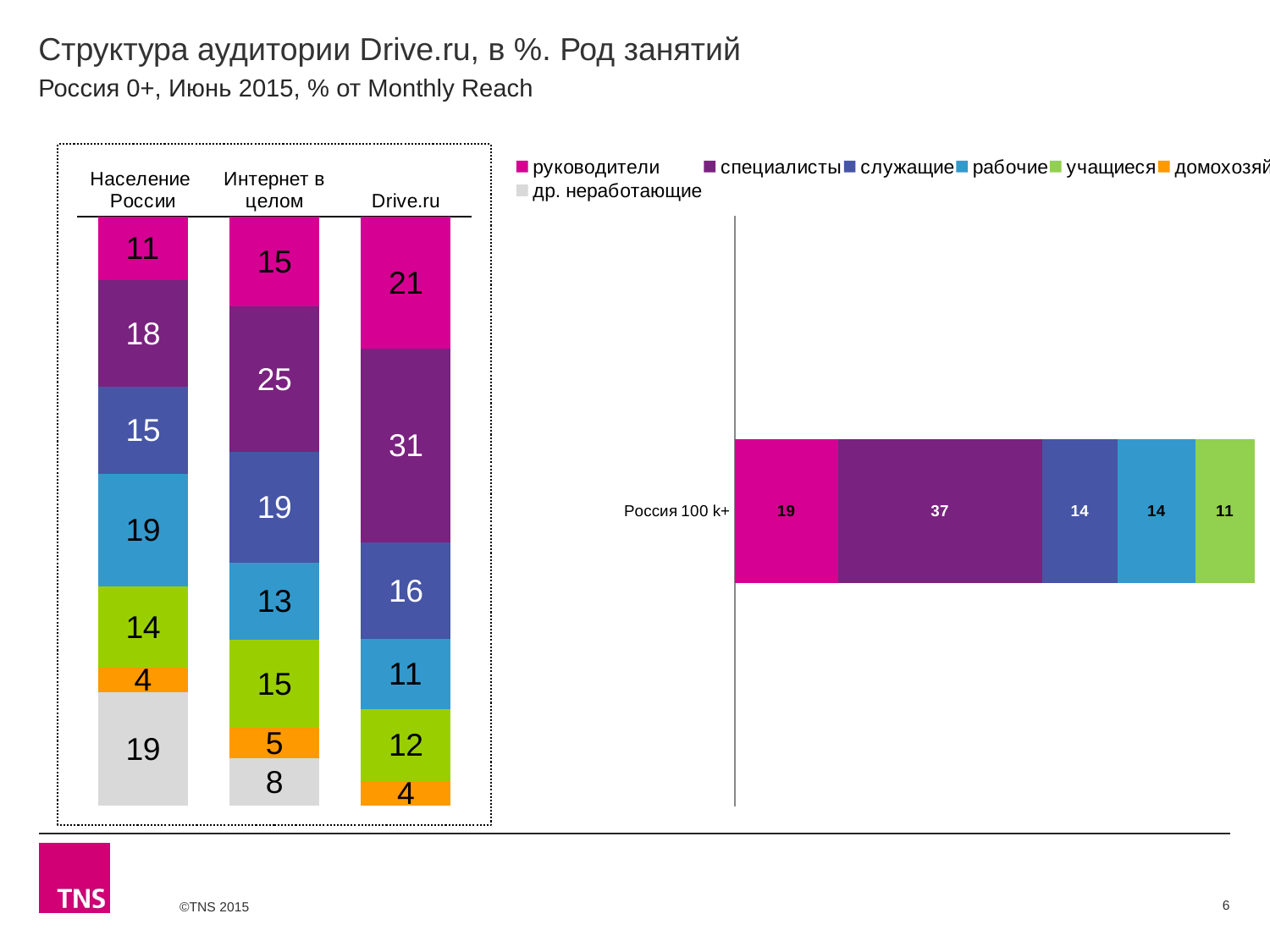
How many bars does the left chart show? 3 In the left chart, what is the value for руководители in the Население России bar? 11 In the left chart, what is the value for специалисты in the Drive.ru bar? 31 In the left chart, which is larger: учащиеся for Население России or учащиеся for Drive.ru? Население России In the right chart, which segment of the Россия 100 k+ bar is the largest? специалисты In the right chart, what is the value for специалисты for Россия 100 k+? 37 What type of chart is the right chart? Stacked bar chart In the left chart, what is the value for рабочие in the Интернет в целом bar? 13 In the left chart, what is the difference between the специалисты values for Drive.ru and Население России? 13 In the left chart, what is the value for др. неработающие in the Интернет в целом bar? 8 In the left chart, which bar has the highest value for руководители? Drive.ru How many series does the legend list? 7